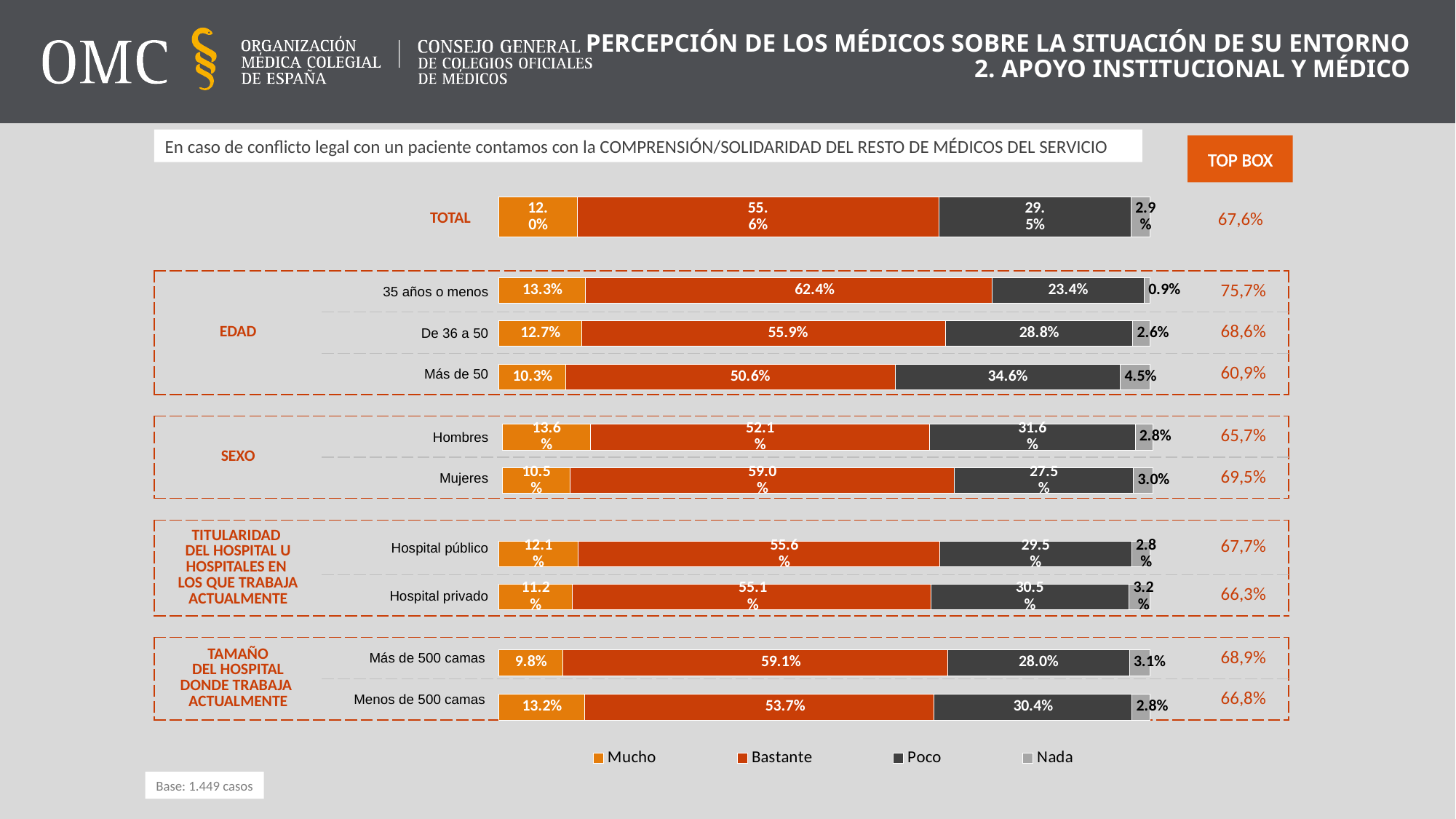
How many series does the legend list? 4 Which category has the lowest Mucho value? Más de 500 camas What is the Nada value for Hospital privado? 3.2% How many bars (categories) are plotted in the chart, including TOTAL? 10 How much larger is the Poco value for Más de 50 than for 35 años o menos? 11.2 percentage points What is the Mucho value for Hombres? 13.6% What is the TOP BOX value shown for the 35 años o menos group? 75,7% What kind of chart is shown on the slide? Stacked bar chart Which has a larger Bastante value, Hombres or Mujeres? Mujeres Which category has the highest Bastante value? 35 años o menos What is the Poco value for the Más de 50 group? 34.6% What percentage of doctors aged 35 años o menos answered Bastante? 62.4%